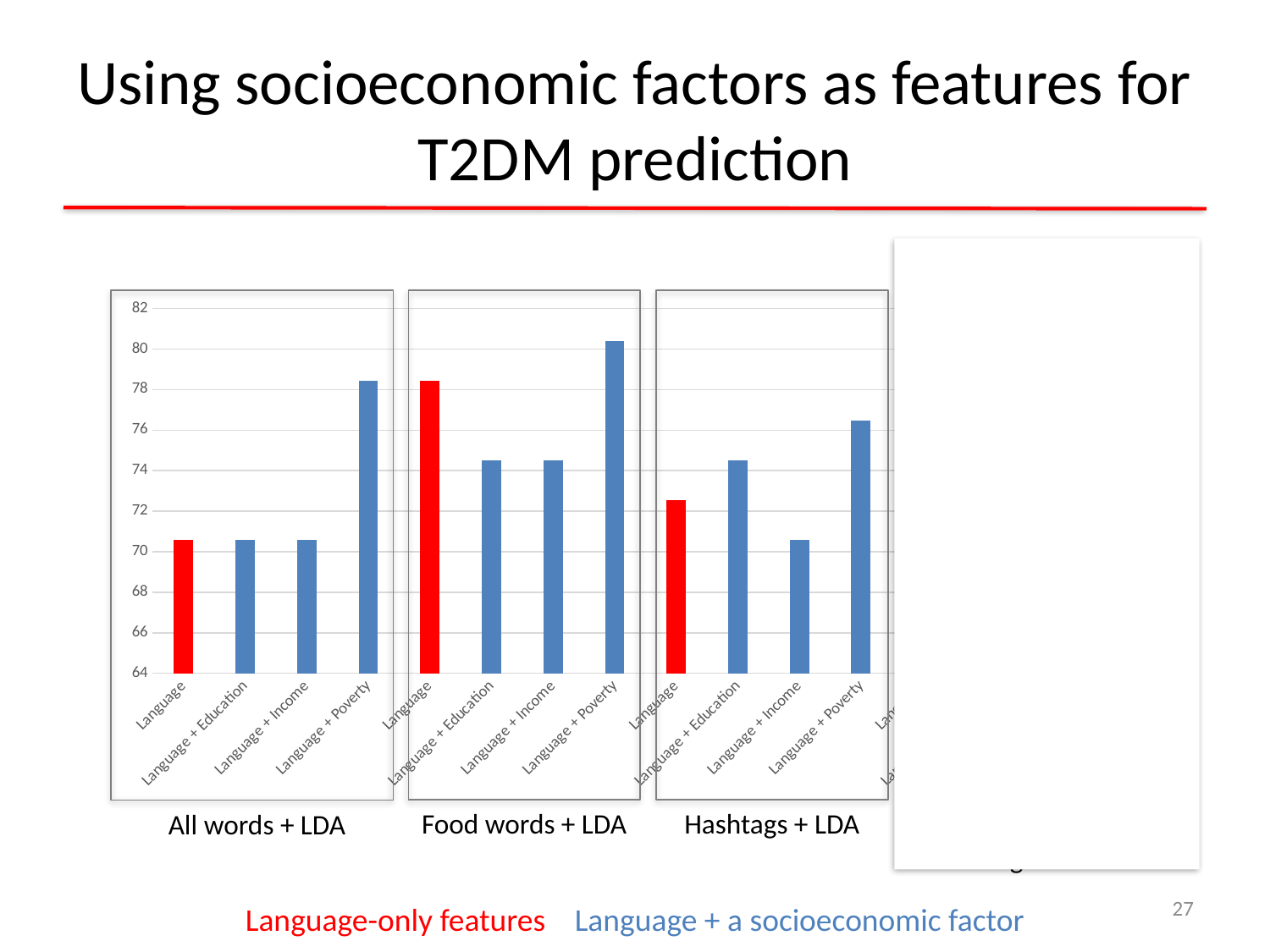
How many categories are shown in the All words + LDA chart? 4 In the Food words + LDA chart, is the value for Language greater or less than 76? greater In the Food words + LDA chart, which category has the highest value? Language + Poverty In the All words + LDA chart, is the value for Language + Poverty greater or less than 76? greater In the Hashtags + LDA chart, which is larger: Language + Education or Language + Income? Language + Education In the All words + LDA chart, which category has the highest value? Language + Poverty In the Hashtags + LDA chart, which category has the lowest value? Language + Income What kind of chart is the Food words + LDA chart? bar chart In the Hashtags + LDA chart, is the value for Language greater or less than 70? greater According to the slide, what do the red bars represent? Language-only features In the Hashtags + LDA chart, which category has the highest value? Language + Poverty